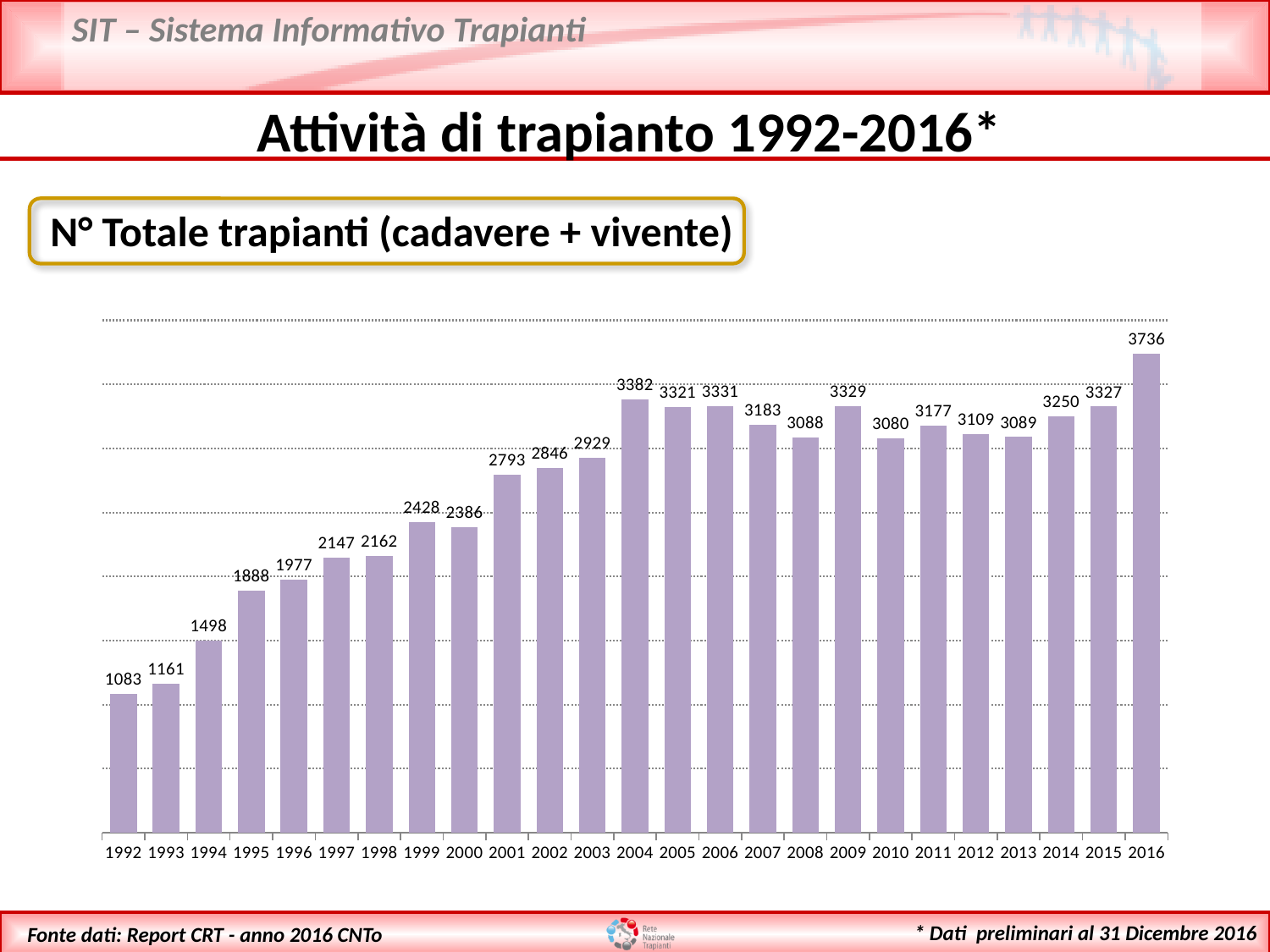
What is the value shown for 2004? 3382 What is the difference between the values for 2016 and 1992? 2653 What is the difference between the values for 2004 and 2003? 453 How many years are shown on the x axis of the chart? 25 What is the value shown for 2010? 3080 What is the total number of transplants shown for 2016? 3736 What type of chart is shown on the slide? bar chart What is the value shown for 1992? 1083 Which year has the lowest value in the chart? 1992 Which year has the larger value, 1999 or 2000? 1999 What is the overall trend of the values from 1992 to 2016? rising Which year has the highest value in the chart? 2016